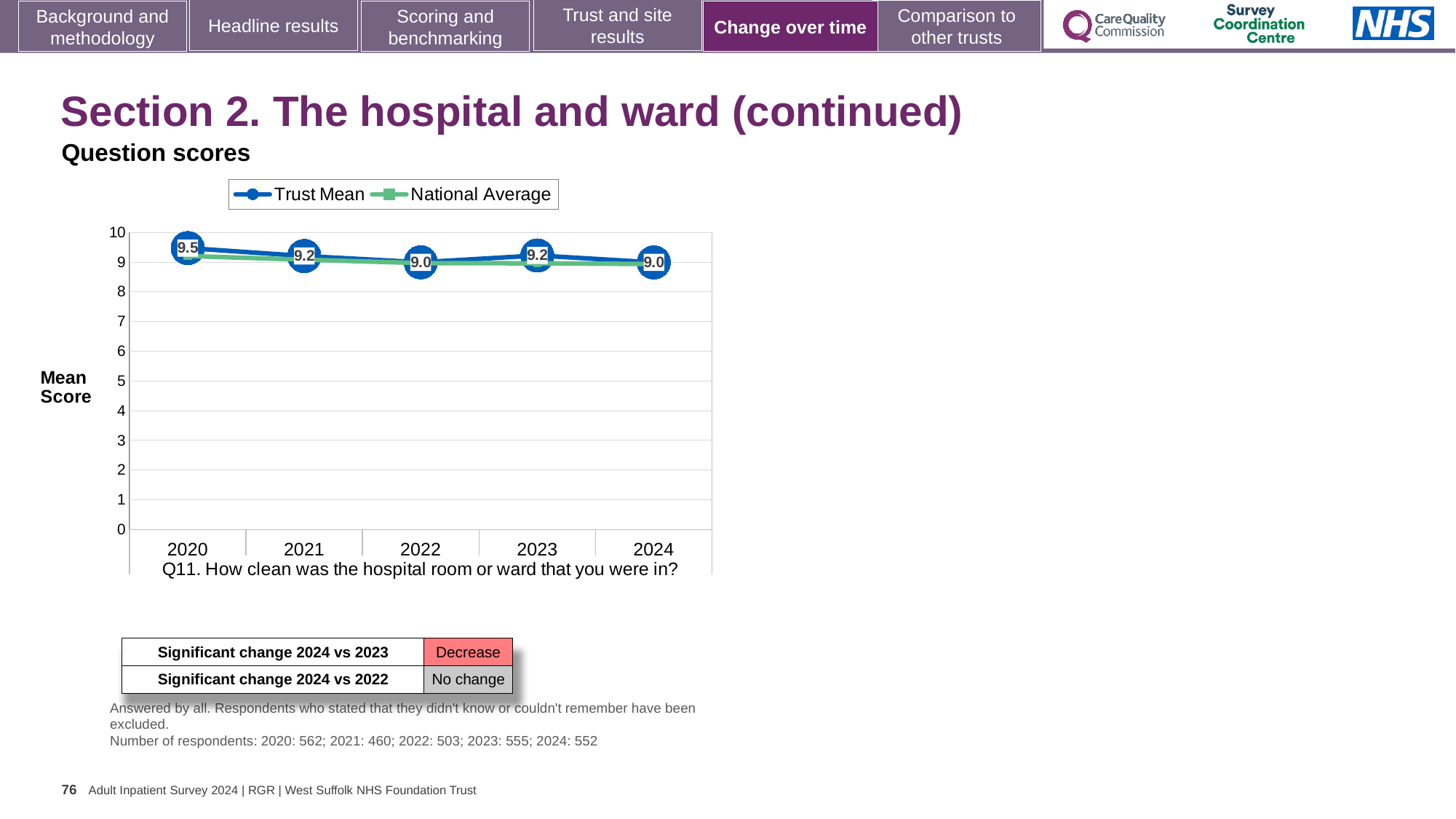
What is the difference between the Trust Mean in 2020 and in 2024? 0.5 Does the Trust Mean rise or fall overall from 2020 to 2024? fall In which year is the Trust Mean highest? 2020 What is the Trust Mean score for 2024? 9.0 How many years are shown on the x axis? 5 What is the Trust Mean score for 2023? 9.2 Which is larger, the Trust Mean for 2021 or for 2022? 2021 Is the National Average value for 2020 greater or less than 8? greater What kind of chart is shown? line chart What question is the chart about, as shown beneath the x axis? Q11. How clean was the hospital room or ward that you were in? What is the Trust Mean score for 2020? 9.5 How many series does the legend list? 2